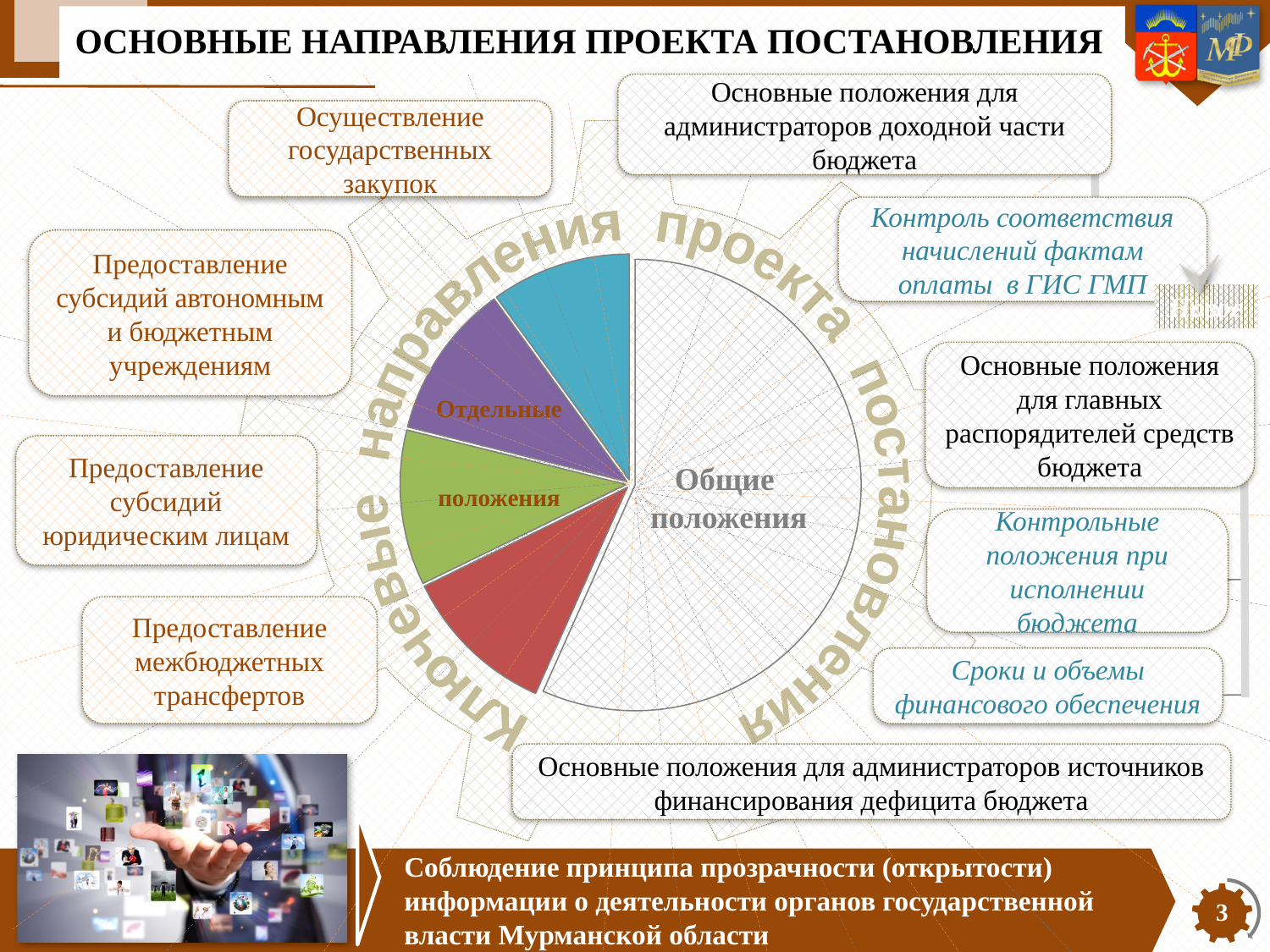
How many slices does the pie chart have? 5 Which is larger in the pie chart: the white slice labelled "Общие положения" or the green slice? Общие положения What kind of chart is shown in the centre of the slide? pie chart What label is printed across the coloured slices of the pie chart? Отдельные положения What label is printed inside the large white slice of the pie chart? Общие положения Which is larger in the pie chart: the white slice labelled "Общие положения" or the red slice? Общие положения Which slice of the pie chart is the largest? Общие положения